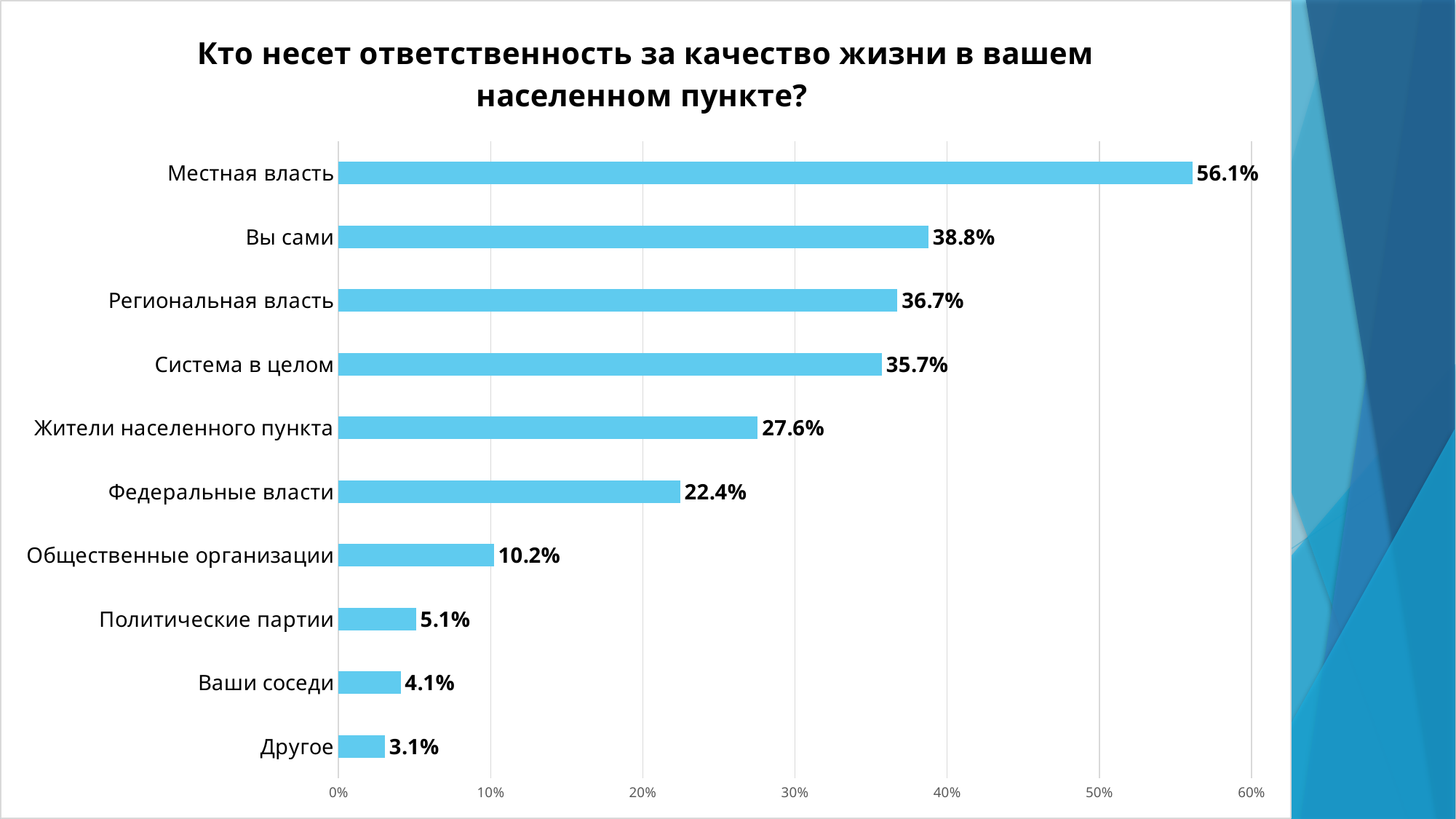
Which category has the highest value? Местная власть Is the value for Система в целом greater or less than 30%? greater Which category has the lowest value? Другое What is the value for Ваши соседи? 4.1% What is the value for Местная власть? 56.1% What is the difference between the values for Общественные организации and Политические партии? 5.1% What is the title of the chart? Кто несет ответственность за качество жизни в вашем населенном пункте? What is the difference between the values for Местная власть and Вы сами? 17.3% How many categories are shown in the chart? 10 What is the value for Федеральные власти? 22.4% Which is larger, the value for Жители населенного пункта or the value for Федеральные власти? Жители населенного пункта What kind of chart is shown on the slide? bar chart